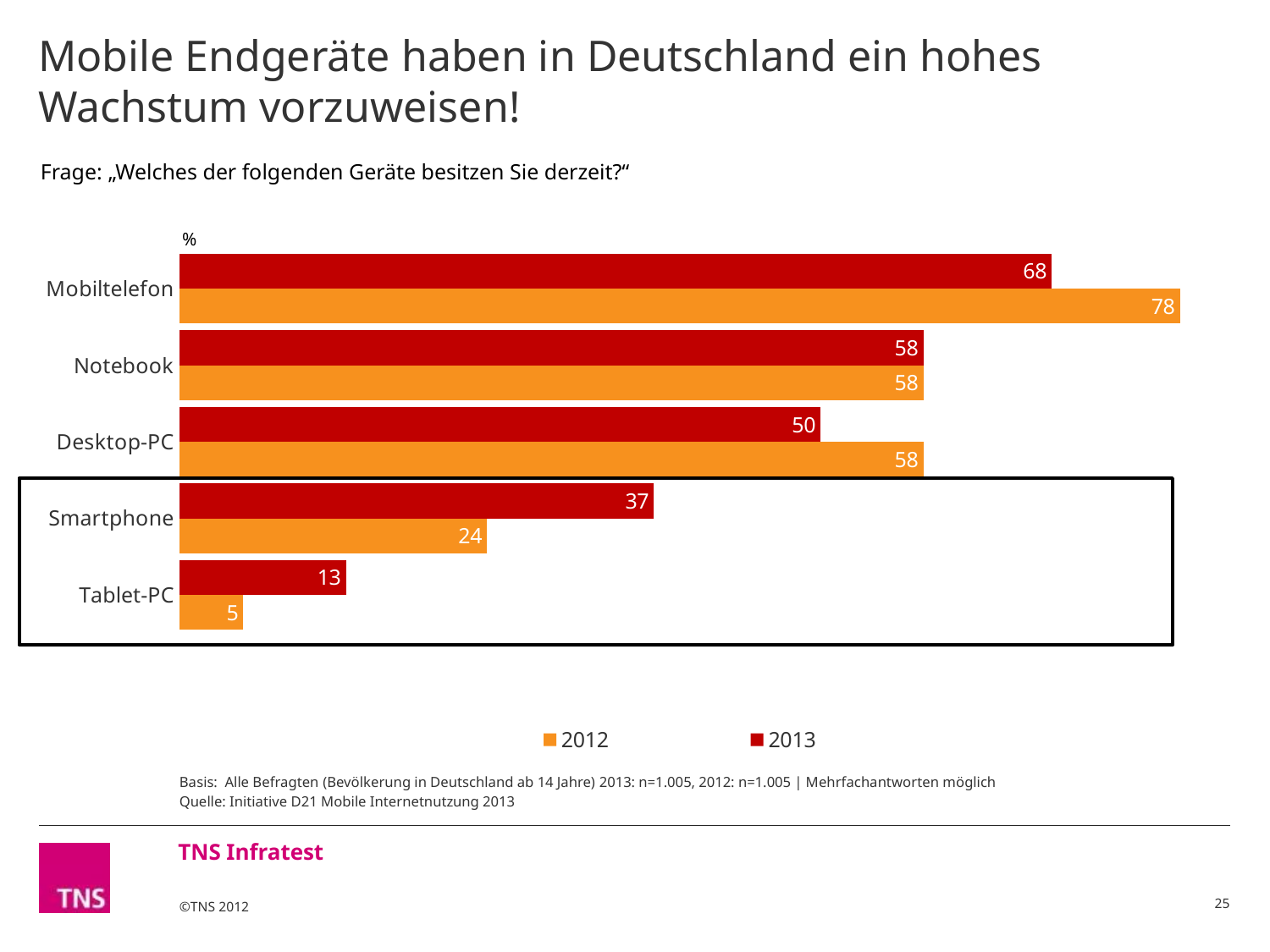
What kind of chart is shown on the slide? Bar chart What is the difference between the 2013 and 2012 values for Smartphone? 13 How many device categories are shown in the chart? 5 What is the difference between the 2012 and 2013 values for Mobiltelefon? 10 What is the value for Tablet-PC in 2012? 5 How many series does the legend list? 2 Which is larger for Desktop-PC, the 2012 value or the 2013 value? 2012 Which category has the highest value in 2013? Mobiltelefon Which category has the lowest value in 2012? Tablet-PC What is the value for Smartphone in 2013? 37 What is the value for Mobiltelefon in 2012? 78 Which colour represents the 2013 series in the chart? Red